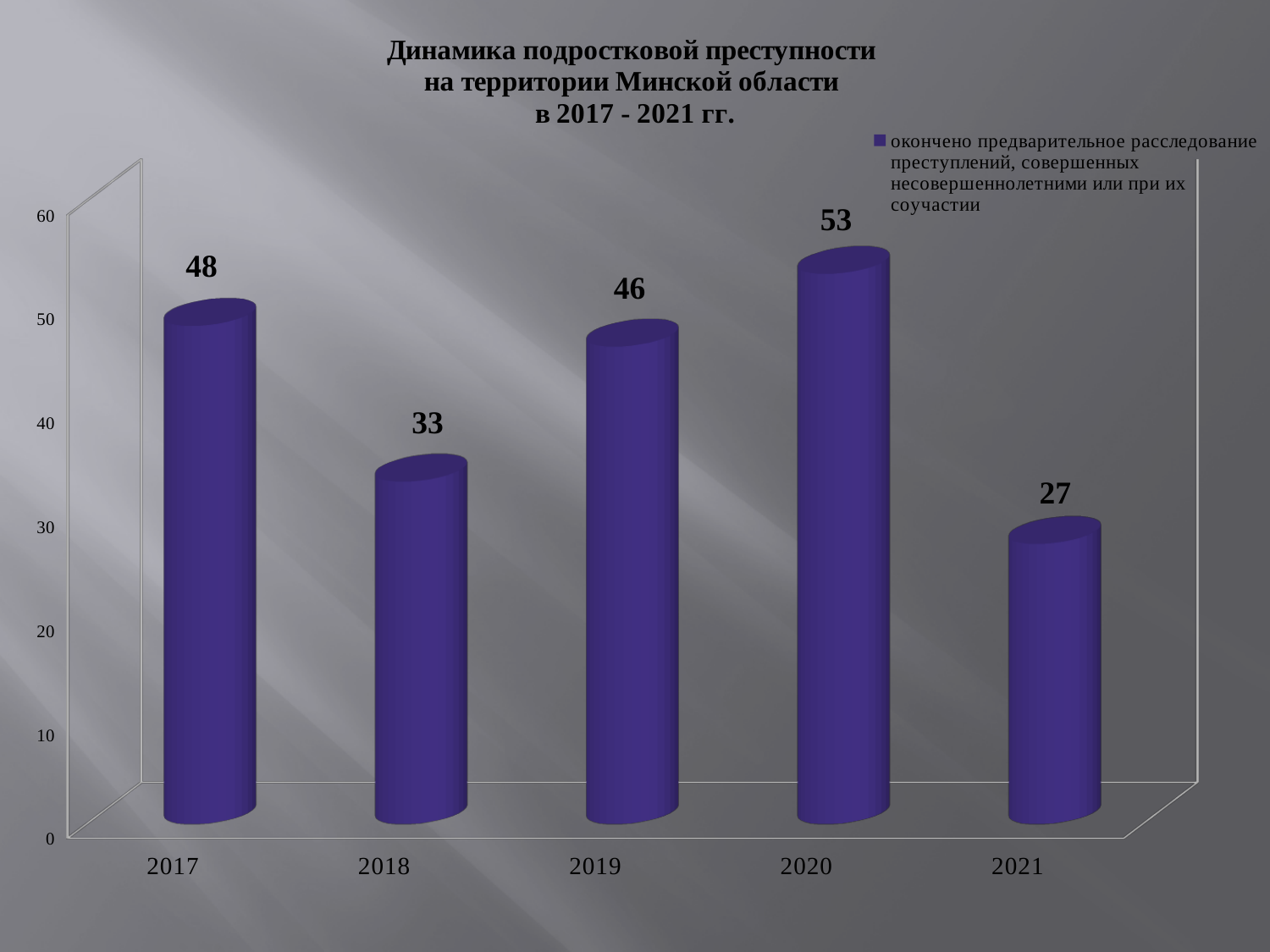
Which is larger, the value for 2019 or the value for 2017? 2017 What is the difference between the values for 2020 and 2021? 26 What is the difference between the values for 2017 and 2018? 15 How many series does the legend list? 1 Which year has the highest value? 2020 What is the value for 2018? 33 What is the value for 2017? 48 What is the value for 2021? 27 How many years are shown on the x axis? 5 Is the value for 2020 greater or less than 50? greater What kind of chart is shown on the slide? bar chart Which year has the lowest value? 2021